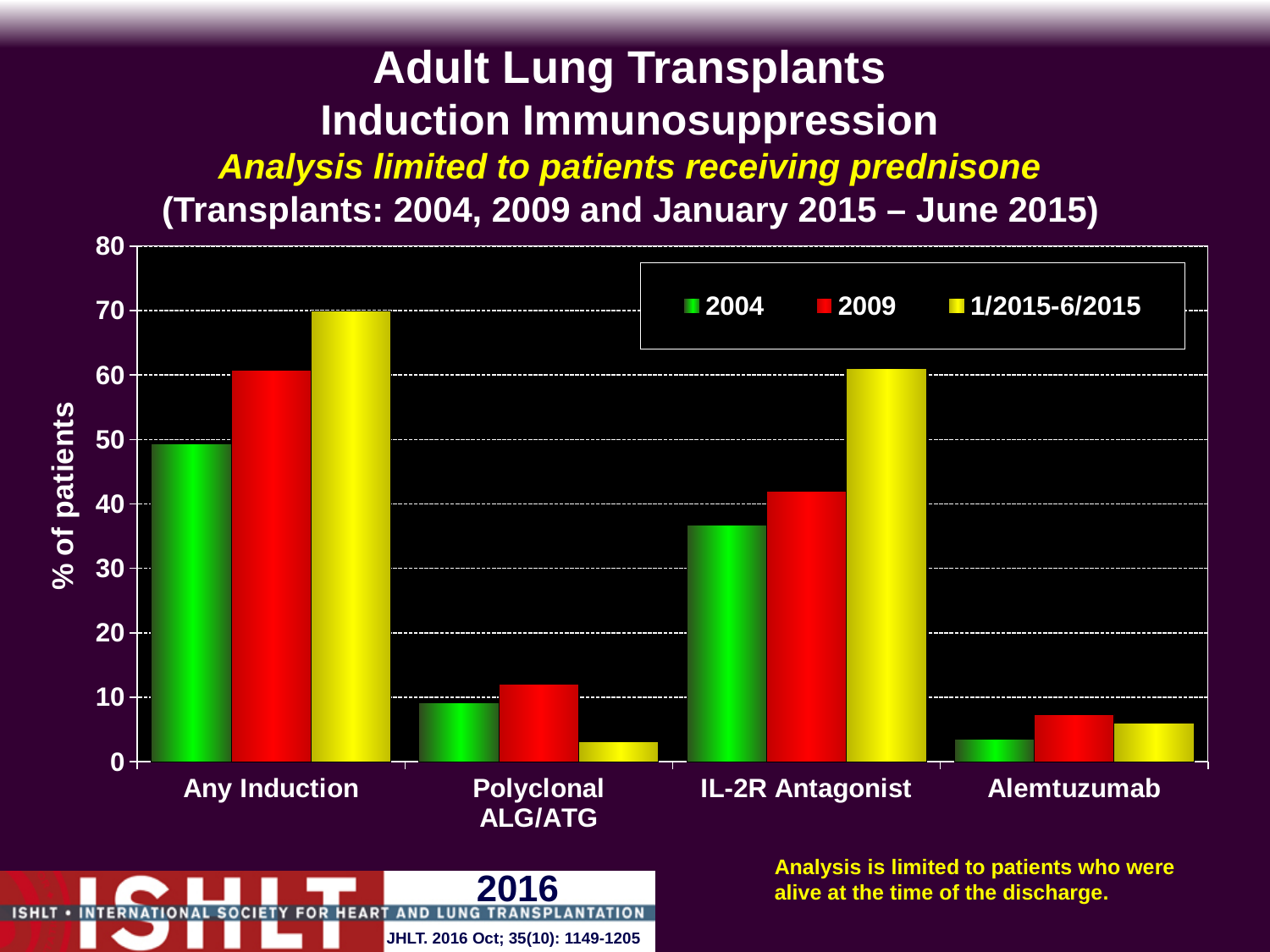
What kind of chart is shown on the slide? bar chart Which is larger: the 2004 value for Any Induction or the 2009 value for IL-2R Antagonist? 2004 value for Any Induction How many induction categories are shown on the x axis? 4 For Any Induction, which series has the highest value? 1/2015-6/2015 Is the 2009 value for Polyclonal ALG/ATG greater or less than 20? less How many series does the legend list? 3 For Polyclonal ALG/ATG, which series has the lowest value? 1/2015-6/2015 Which category and series has the tallest bar in the chart? Any Induction, 1/2015-6/2015 Is the 2004 value for Any Induction greater or less than 40? greater Do the values for Any Induction rise or fall from 2004 to 1/2015-6/2015? rise Is the 1/2015-6/2015 value for Any Induction greater or less than 60? greater